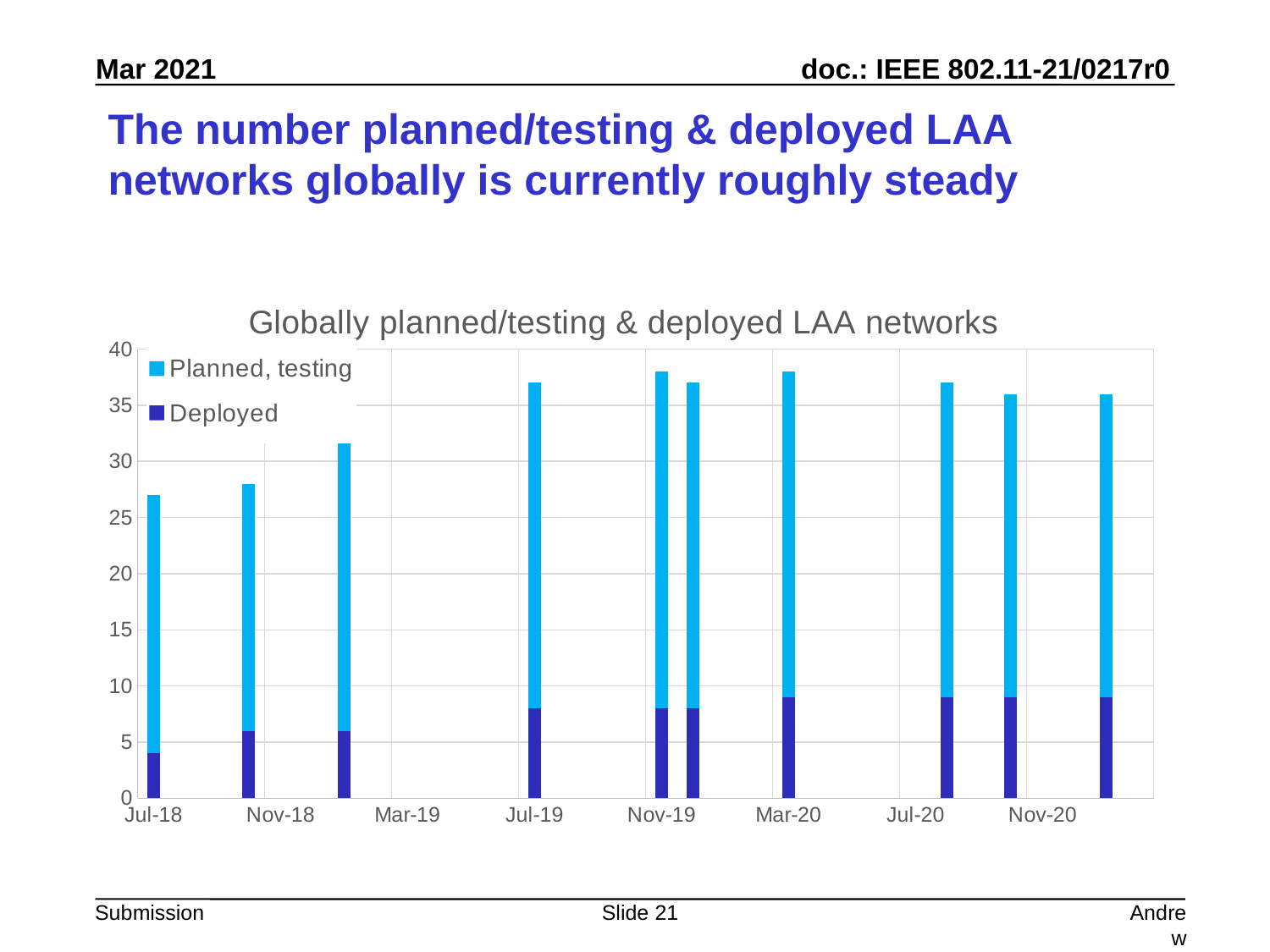
Is the Deployed value for Jul-18 greater or less than 5? less Does the Deployed series generally rise or fall from Jul-18 to the last bar? rise Is the total height of the Jul-19 bar greater or less than 35? greater Which has the larger Deployed value, Jul-18 or Mar-20? Mar-20 Is the Deployed value for Mar-20 greater or less than 10? less Which series is shown in dark blue in the chart? Deployed How many series does the legend list? 2 What is the title of the chart? Globally planned/testing & deployed LAA networks What kind of chart is shown on the slide? Stacked bar chart Which bar is taller in total, Jul-18 or Jul-19? Jul-19